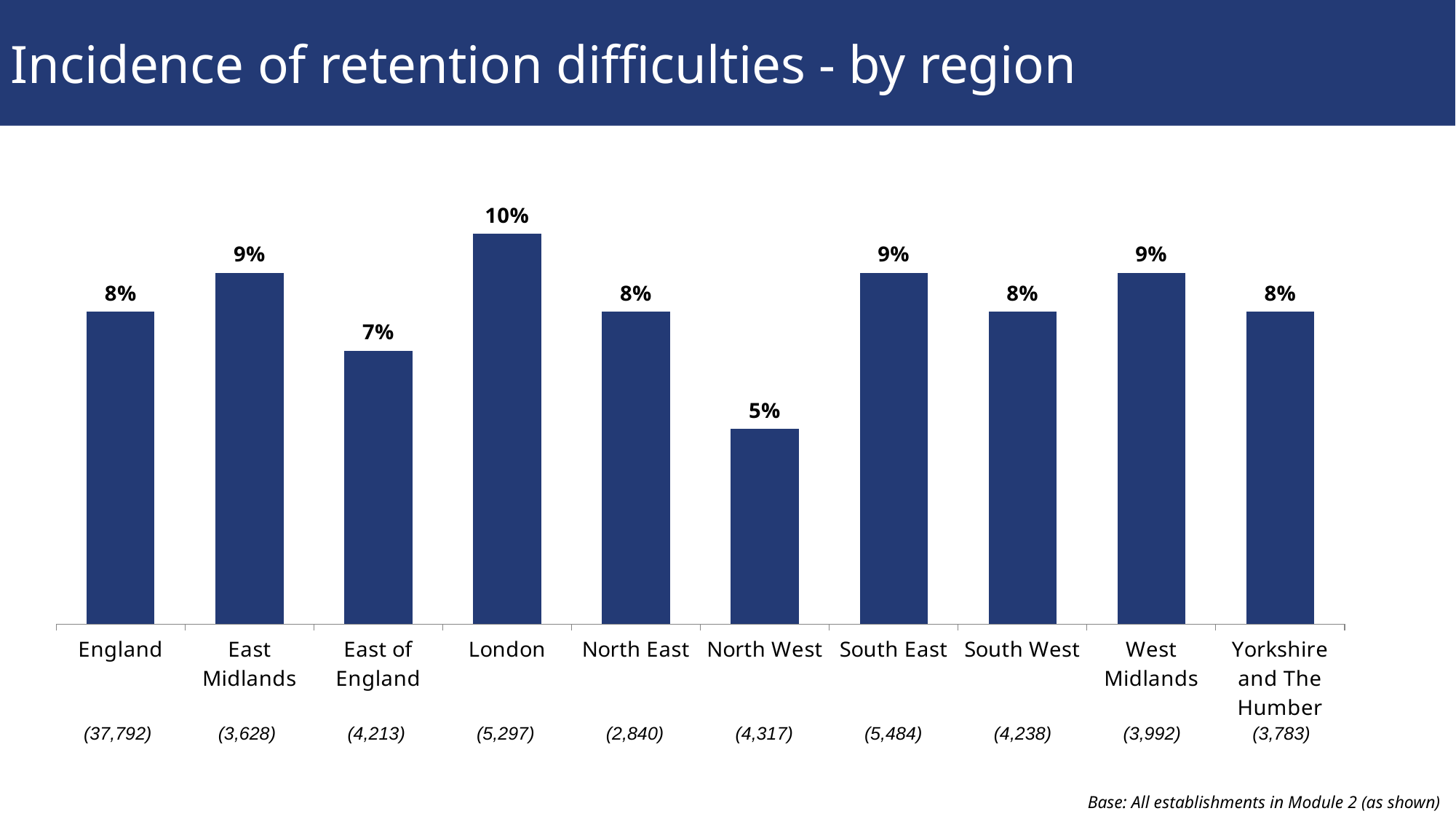
What is the base number shown for England? 37,792 What is the difference between the values for East Midlands and East of England? 2% What is the value for East of England? 7% What is the value for England? 8% Which region has the highest value? London What is the value for North West? 5% What kind of chart is shown on the slide? Bar chart What is the difference between the values for London and North West? 5% What is the value for London? 10% Which is larger, the value for South East or the value for South West? South East Which region has the lowest value? North West How many regions are shown on the chart? 10